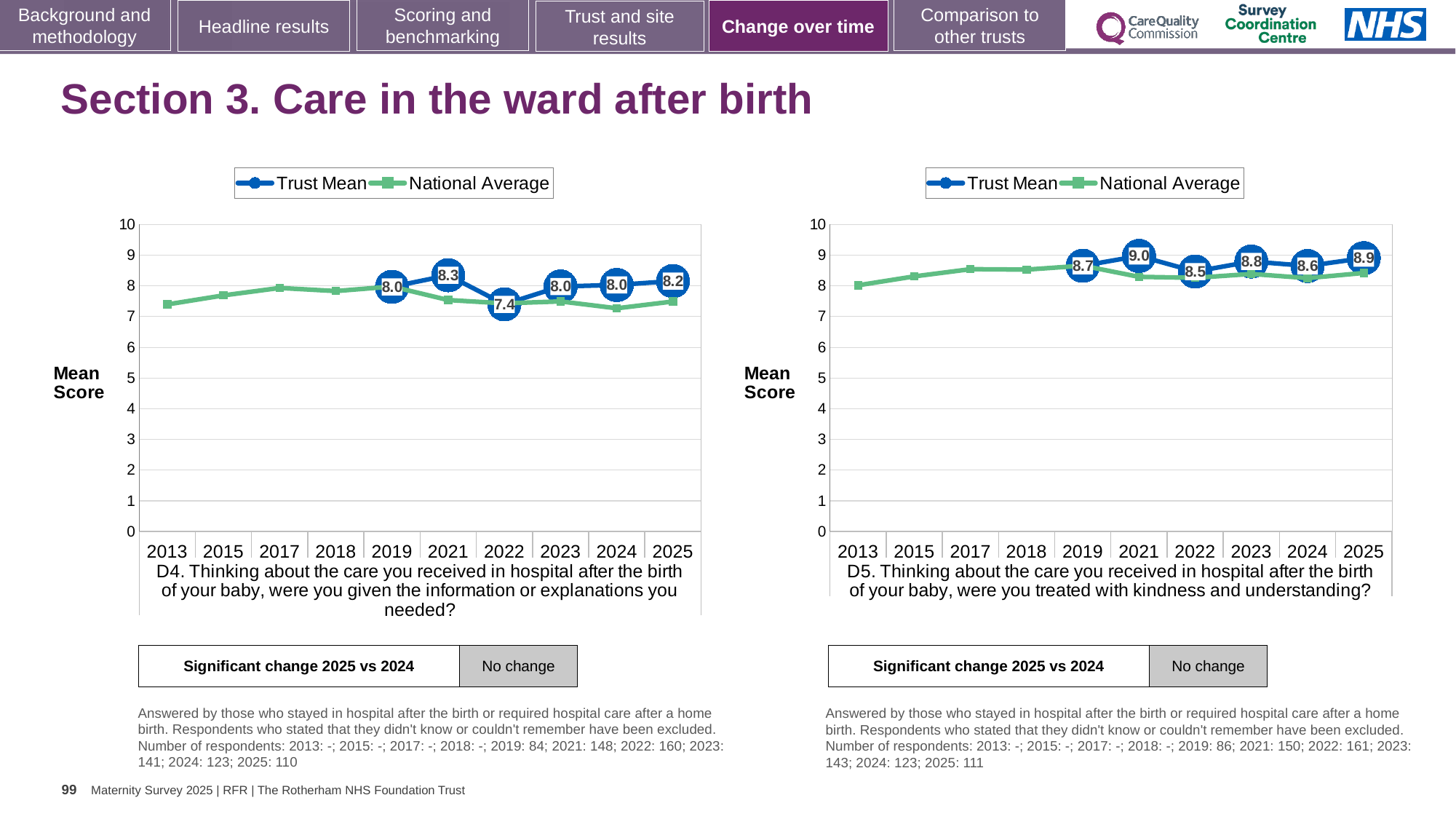
In the D4 chart (left), what is the Trust Mean for 2022? 7.4 In the D4 chart (left), which year has the lowest Trust Mean? 2022 In the D5 chart (right), what is the Trust Mean for 2025? 8.9 How many series does the legend of the D4 chart (left) list? 2 In the D4 chart (left), what is the Trust Mean for 2025? 8.2 In the D5 chart (right), is the National Average for 2013 greater or less than 9? less In the D5 chart (right), is the Trust Mean for 2024 or 2025 larger? 2025 In the D5 chart (right), which year has the lowest Trust Mean? 2022 What kind of chart is the D5 chart (right)? line chart In the D4 chart (left), which year has the highest Trust Mean? 2021 In the D4 chart (left), what is the difference between the Trust Mean in 2021 and in 2022? 0.9 In the D5 chart (right), what is the Trust Mean for 2021? 9.0